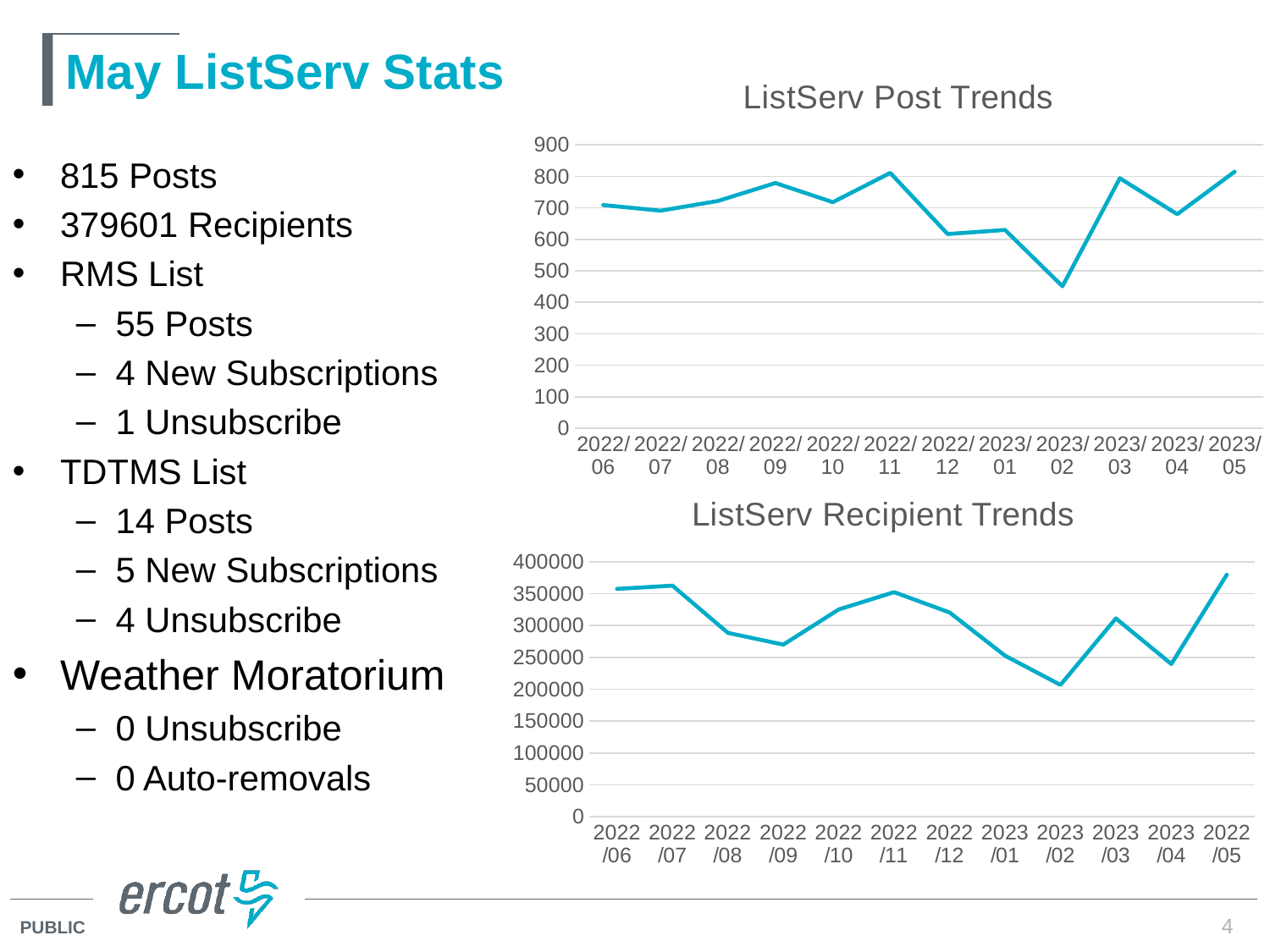
On the ListServ Recipient Trends chart, which month has the highest value? 2022/05 On the ListServ Post Trends chart, which is larger, the value for 2023/03 or the value for 2023/02? 2023/03 What kind of chart is the ListServ Recipient Trends chart? line chart On the ListServ Post Trends chart, is the value for 2023/02 greater or less than 500? less On the ListServ Recipient Trends chart, which month has the lowest value? 2023/02 How many months are plotted on the ListServ Post Trends chart? 12 What kind of chart is the ListServ Post Trends chart? line chart What is the title of the lower chart on the slide? ListServ Recipient Trends On the ListServ Post Trends chart, which month has the lowest value? 2023/02 On the ListServ Post Trends chart, is the value for 2022/09 greater or less than 700? greater On the ListServ Recipient Trends chart, is the value for 2022/09 greater or less than 300000? less On the ListServ Recipient Trends chart, do the values rise or fall from 2022/07 to 2022/09? fall